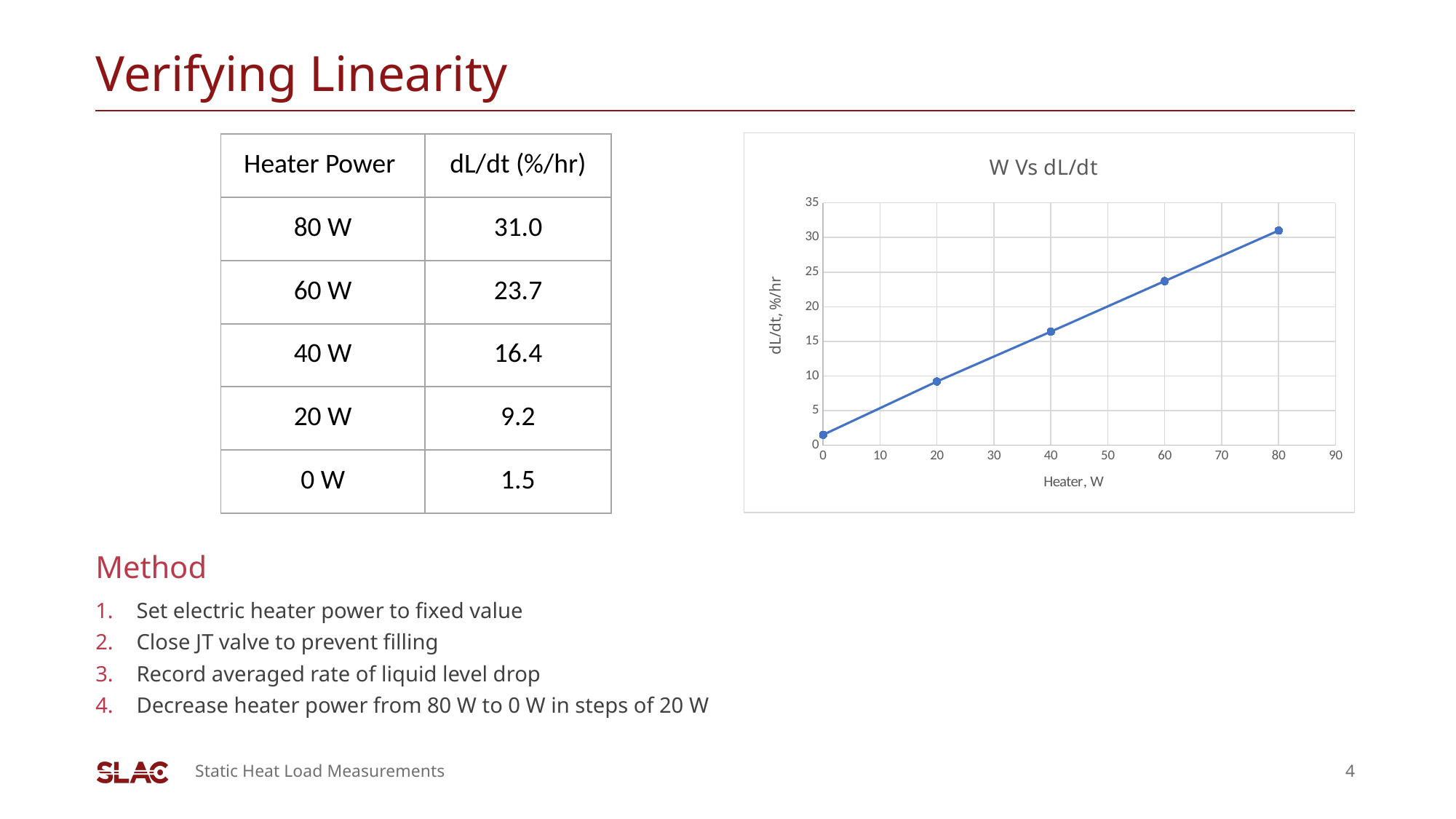
Is the dL/dt value at 40 W greater or less than 15? greater What is the label of the x axis of the chart? Heater, W Which has the larger dL/dt value on the chart, 60 W or 40 W? 60 W Is the dL/dt value at 20 W greater or less than 10? less Is the dL/dt value at 80 W greater or less than 30? greater At which heater power is dL/dt lowest on the chart? 0 W What kind of chart is shown on the slide? line chart Does dL/dt rise or fall as heater power increases along the x axis? rise What is the title of the chart? W Vs dL/dt What is the dL/dt value (%/hr) plotted at 60 W, as given on the slide? 23.7 How many data points are plotted on the chart? 5 At which heater power is dL/dt highest on the chart? 80 W